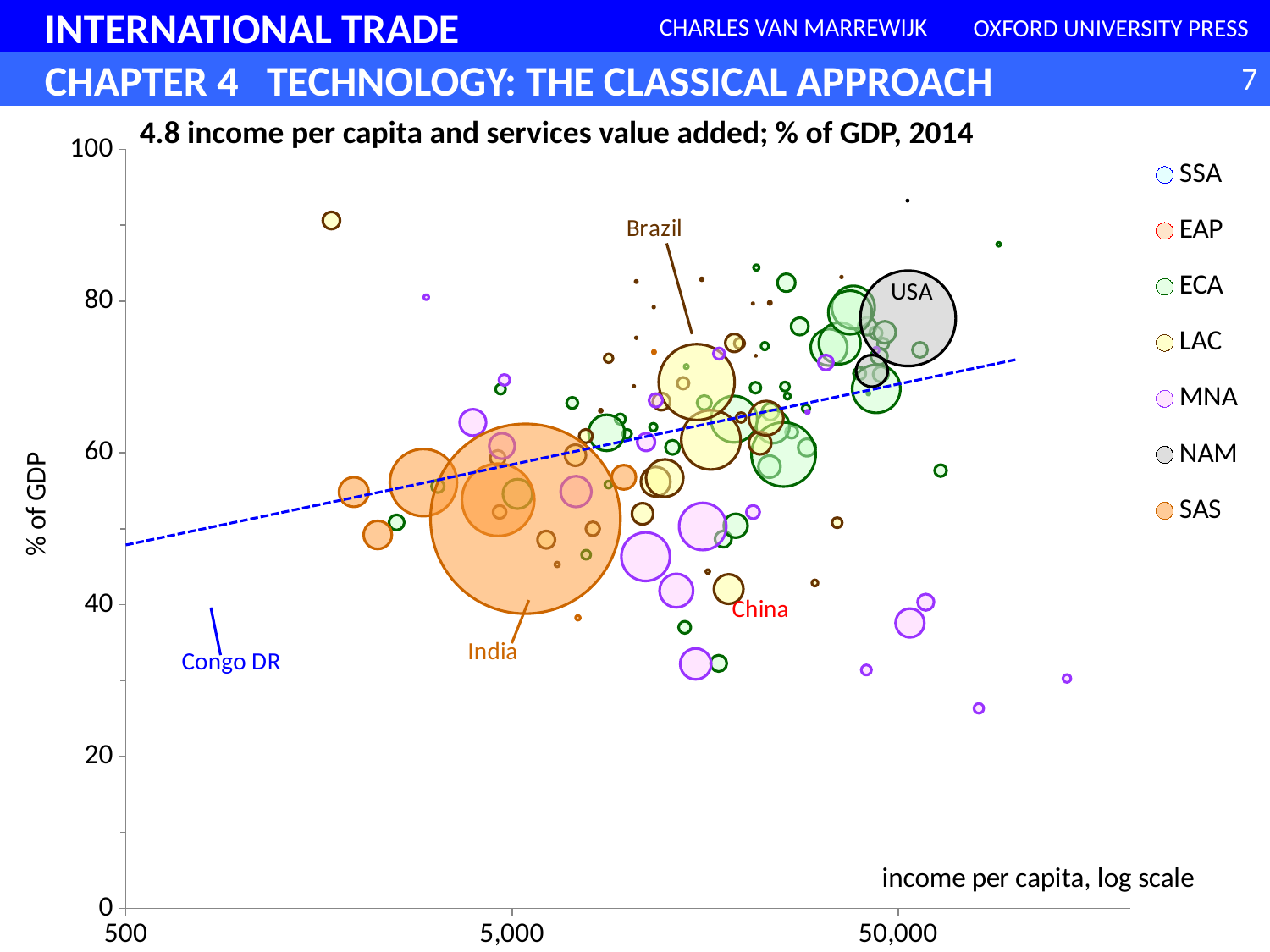
Of the labelled countries, which has the lowest income per capita? Congo DR Is the services value added (% of GDP) for India greater or less than 60? less How many regions does the legend list? 7 Which has a higher services share of GDP, Brazil or China? Brazil What kind of chart is shown on the slide? bubble chart What is the title of the chart? 4.8 income per capita and services value added; % of GDP, 2014 What is the label of the vertical axis? % of GDP Is the services value added (% of GDP) for Brazil greater or less than 60? greater Is the services value added (% of GDP) for the USA greater or less than 60? greater Of the labelled countries, which has the highest income per capita? USA Which has a higher services share of GDP, the USA or India? USA